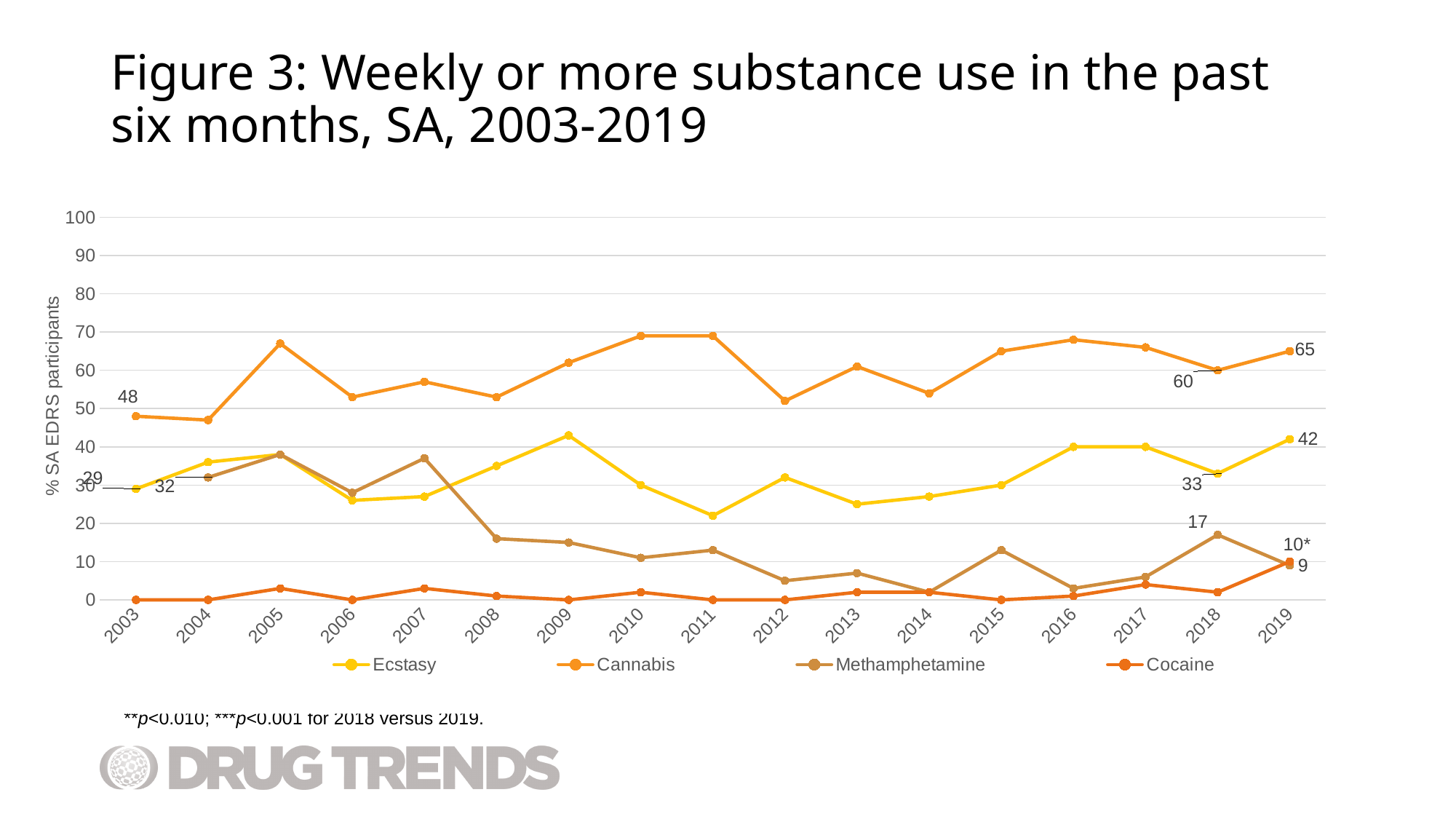
What is the value for Methamphetamine in 2018? 17 What is the value for Ecstasy in 2019? 42 What is the value for Cannabis in 2003? 48 How many years are plotted along the x axis? 17 How many series does the legend list? 4 Which series has the highest value in 2019? Cannabis Is the value for Cannabis in 2010 greater or less than 60? greater What is the value for Cannabis in 2019? 65 What is the value for Cocaine in 2019? 10* What is the difference between the Cannabis values for 2019 and 2018? 5 What type of chart is shown on the slide? Line chart What is the difference between the Ecstasy values for 2019 and 2018? 9